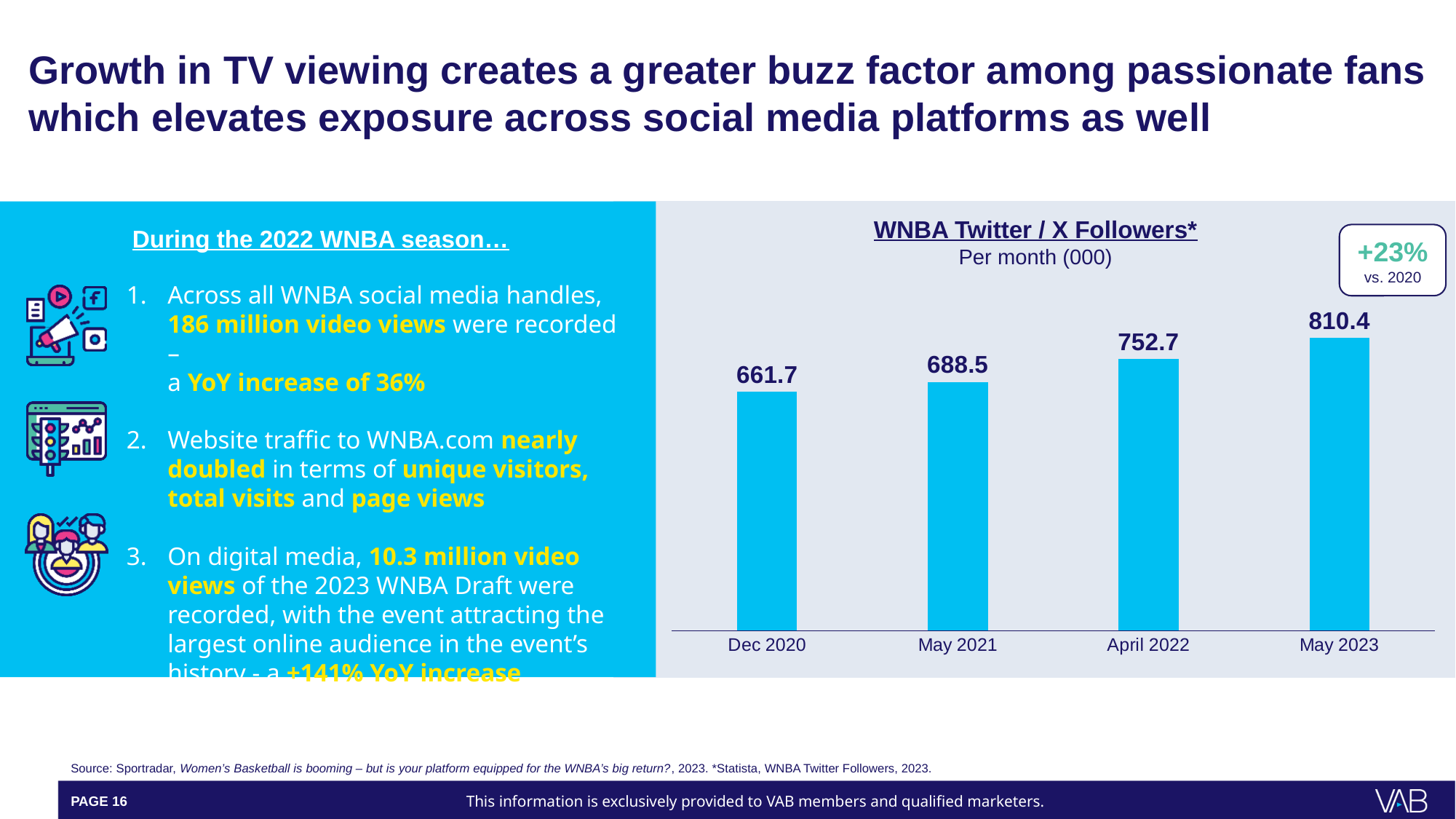
What kind of chart is the WNBA Twitter / X Followers chart? Bar chart What is the value for Dec 2020 in the WNBA Twitter / X Followers chart? 661.7 What is the difference between the May 2023 and Dec 2020 values in the WNBA Twitter / X Followers chart? 148.7 What is the value for May 2021 in the WNBA Twitter / X Followers chart? 688.5 What is the value for April 2022 in the WNBA Twitter / X Followers chart? 752.7 Which is larger in the WNBA Twitter / X Followers chart, the value for May 2021 or April 2022? April 2022 Which month has the lowest value in the WNBA Twitter / X Followers chart? Dec 2020 How many months are shown in the WNBA Twitter / X Followers chart? 4 Which month has the highest value in the WNBA Twitter / X Followers chart? May 2023 What is the value for May 2023 in the WNBA Twitter / X Followers chart? 810.4 Do the values in the WNBA Twitter / X Followers chart rise or fall from Dec 2020 to May 2023? Rise What percentage change vs. 2020 is shown in the callout on the WNBA Twitter / X Followers chart? +23%